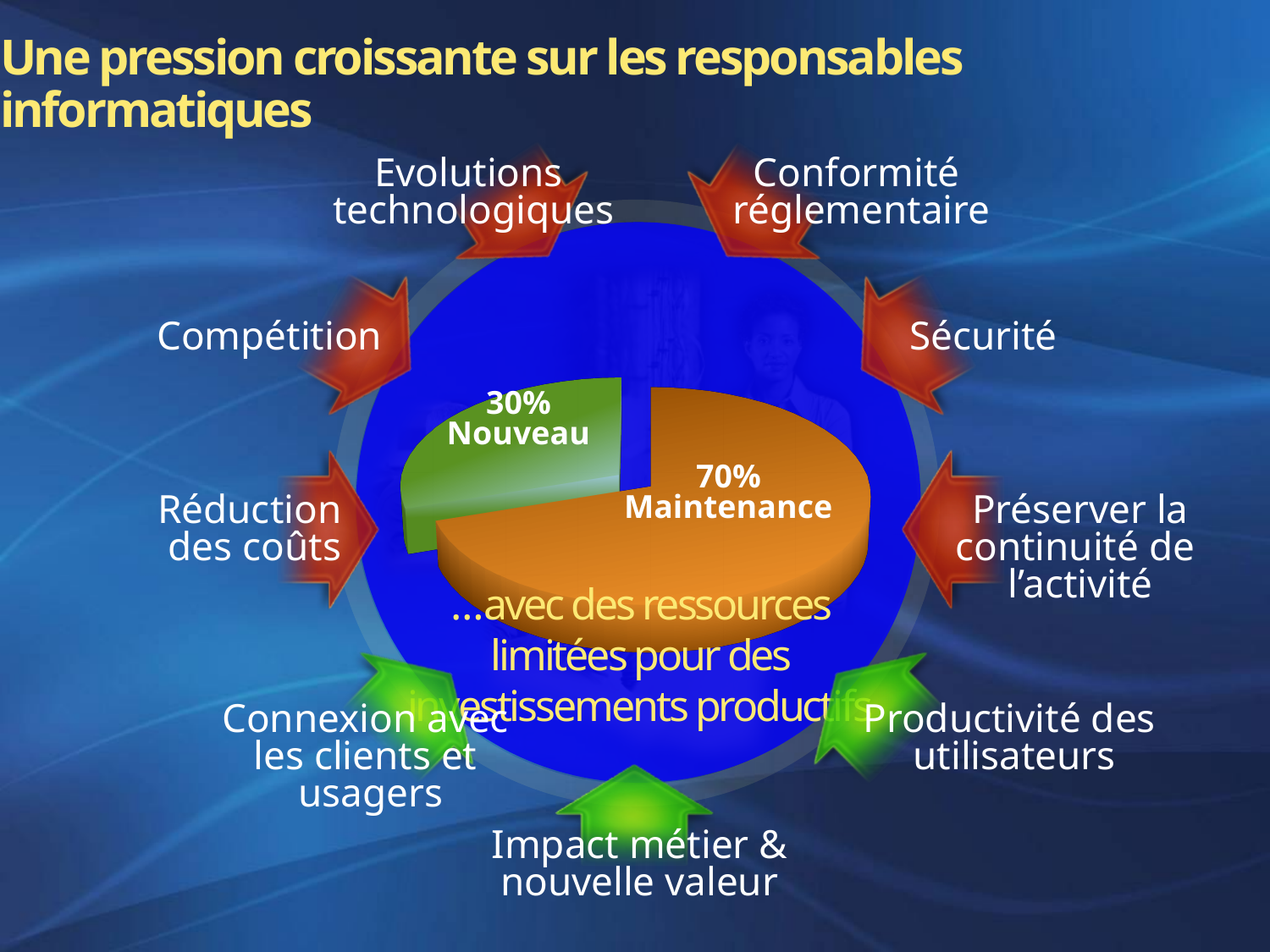
Which is larger in the pie chart, Maintenance or Nouveau? Maintenance Which slice of the pie chart is the smallest? Nouveau What percentage does the pie chart show for Nouveau? 30% What is the difference in percentage points between the Maintenance and Nouveau slices? 40 What colour is the Nouveau slice of the pie chart? green What percentage does the pie chart show for Maintenance? 70% What share of the pie does the Nouveau slice represent? 30% How many slices does the pie chart have? 2 Is the value for Maintenance greater or less than 50%? greater What colour is the Maintenance slice of the pie chart? orange Which slice of the pie chart is the largest? Maintenance What kind of chart is shown in the centre of the slide? pie chart